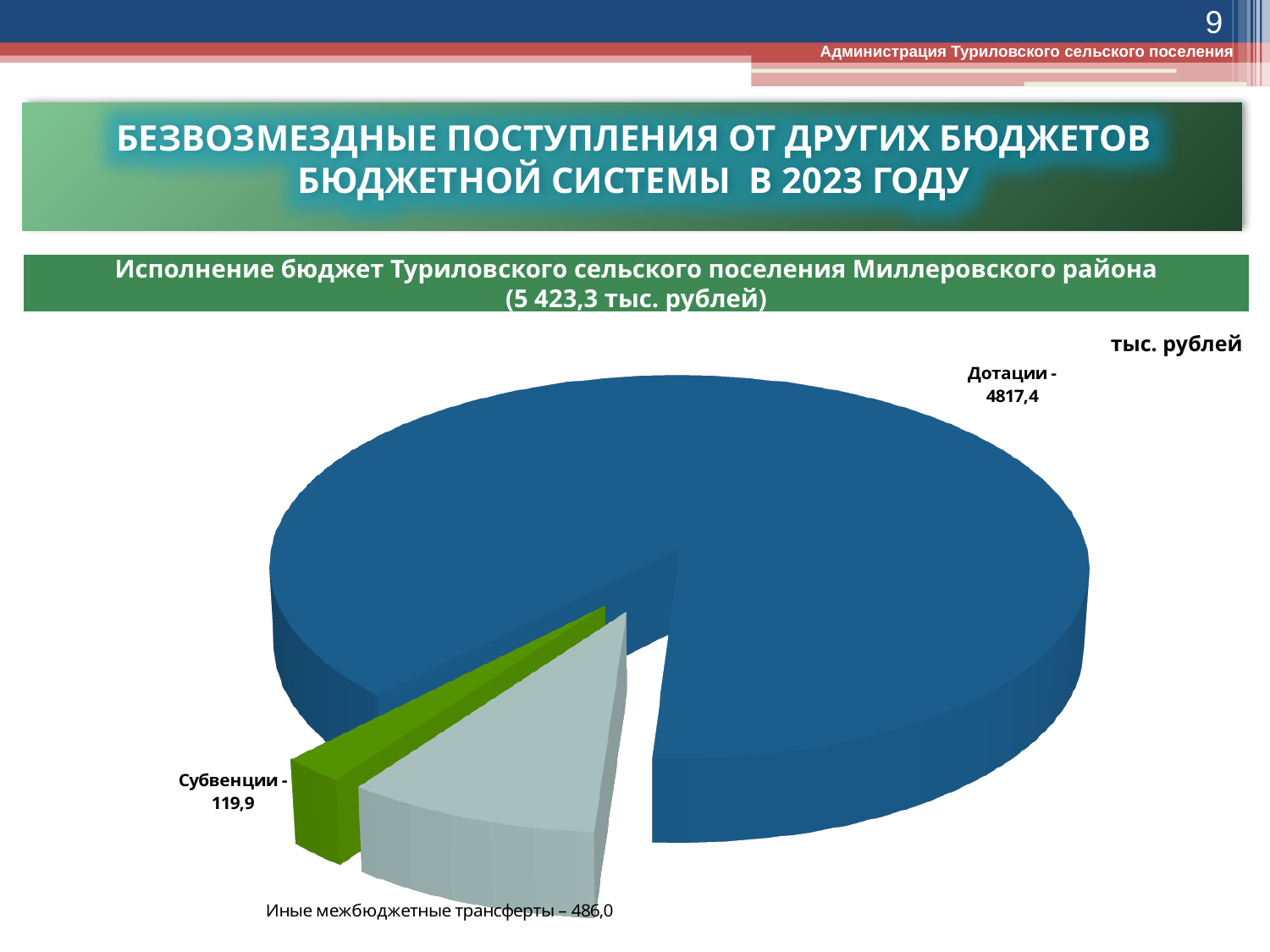
What is the difference between Иные межбюджетные трансферты and Субвенции? 366,1 What is the total of all three slices in the pie chart? 5 423,3 тыс. рублей How many slices does the pie chart have? 3 Which category has the smallest slice of the pie? Субвенции What is the value for Иные межбюджетные трансферты? 486,0 What is the value for Дотации? 4817,4 Which category has the largest slice of the pie? Дотации What unit is indicated for the values in the chart? тыс. рублей Which is larger, Иные межбюджетные трансферты or Субвенции? Иные межбюджетные трансферты What is the value for Субвенции? 119,9 What kind of chart is shown on the slide? Pie chart What is the difference between Дотации and Иные межбюджетные трансферты? 4331,4